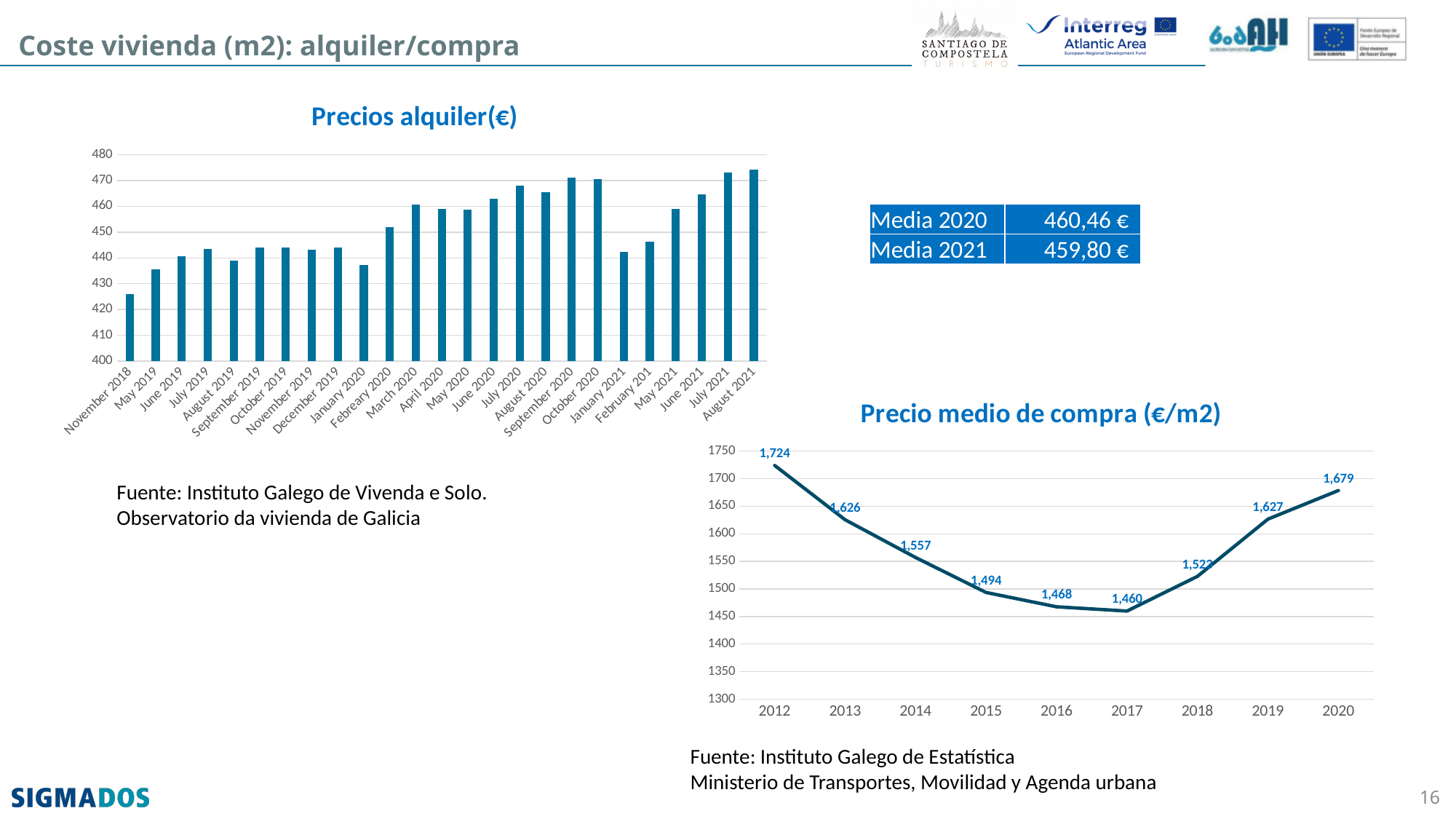
On the 'Precios alquiler(€)' chart, is the value for November 2018 greater or less than 430? less On the 'Precio medio de compra (€/m2)' chart, which year has the highest value? 2012 On the 'Precio medio de compra (€/m2)' chart, do the values rise or fall from 2012 to 2017? Fall On the 'Precio medio de compra (€/m2)' chart, which is larger, the value for 2018 or the value for 2019? 2019 What kind of chart is 'Precio medio de compra (€/m2)'? Line chart On the 'Precio medio de compra (€/m2)' chart, what is the difference between the 2012 value and the 2020 value? 45 On the 'Precio medio de compra (€/m2)' chart, how many years are plotted? 9 On the 'Precio medio de compra (€/m2)' chart, what is the value for 2017? 1,460 On the 'Precios alquiler(€)' chart, which month has the lowest value? November 2018 What kind of chart is 'Precios alquiler(€)'? Bar chart On the 'Precio medio de compra (€/m2)' chart, which year has the lowest value? 2017 On the 'Precio medio de compra (€/m2)' chart, what is the value for 2012? 1,724